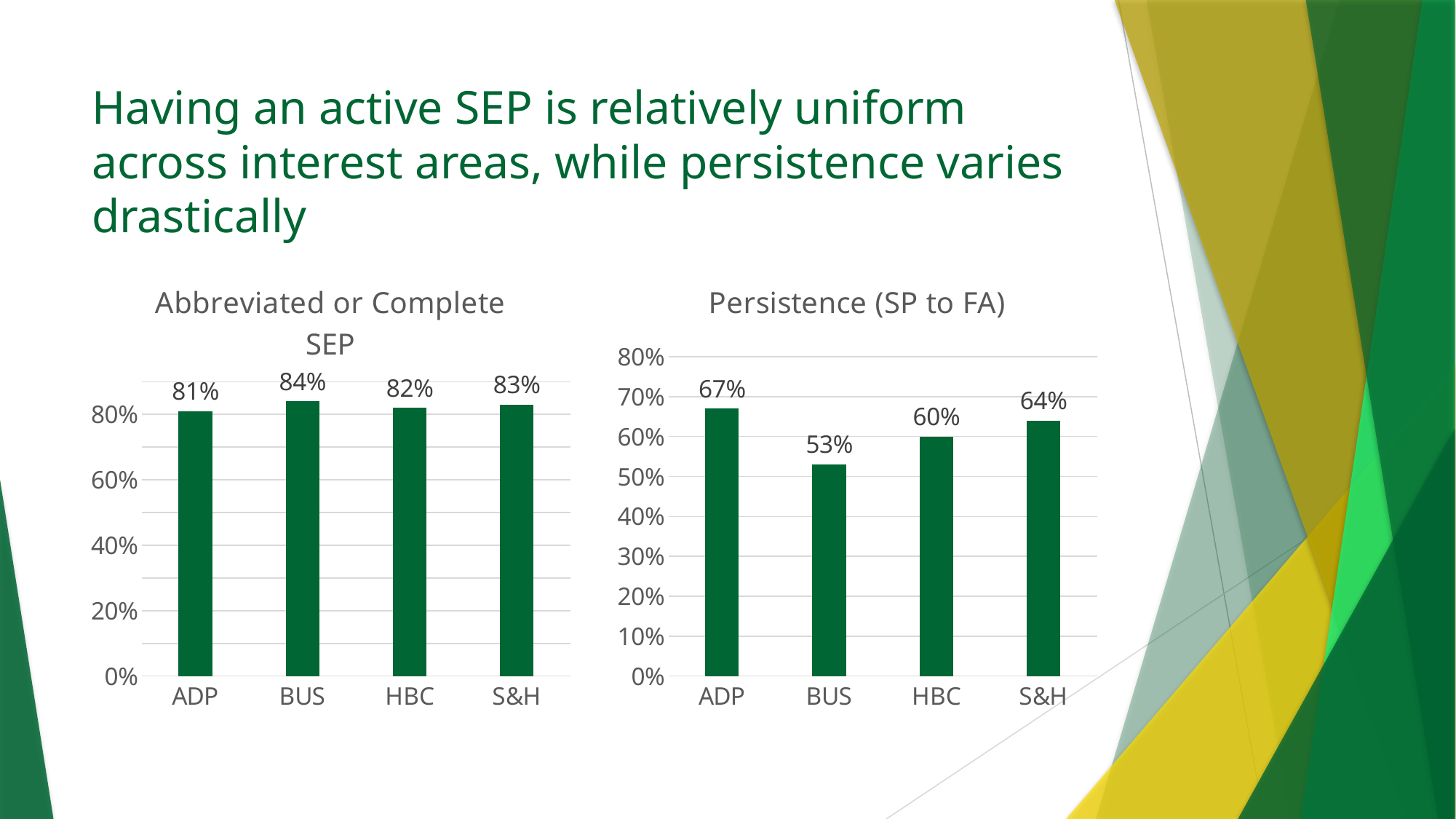
What is the title of the chart on the right side of the slide? Persistence (SP to FA) In the 'Abbreviated or Complete SEP' chart, what is the value for BUS? 84% In the 'Persistence (SP to FA)' chart, which category has the highest value? ADP In the 'Abbreviated or Complete SEP' chart, what is the difference between the values for BUS and ADP? 3% How many categories are shown in the 'Abbreviated or Complete SEP' chart? 4 In the 'Persistence (SP to FA)' chart, is the value for BUS greater or less than 60%? less In the 'Persistence (SP to FA)' chart, what is the difference between the values for ADP and BUS? 14% In the 'Persistence (SP to FA)' chart, what is the value for HBC? 60% In the 'Persistence (SP to FA)' chart, which is larger, the value for HBC or the value for S&H? S&H In the 'Abbreviated or Complete SEP' chart, which category has the highest value? BUS In the 'Persistence (SP to FA)' chart, which category has the lowest value? BUS What kind of chart is the 'Persistence (SP to FA)' chart? bar chart